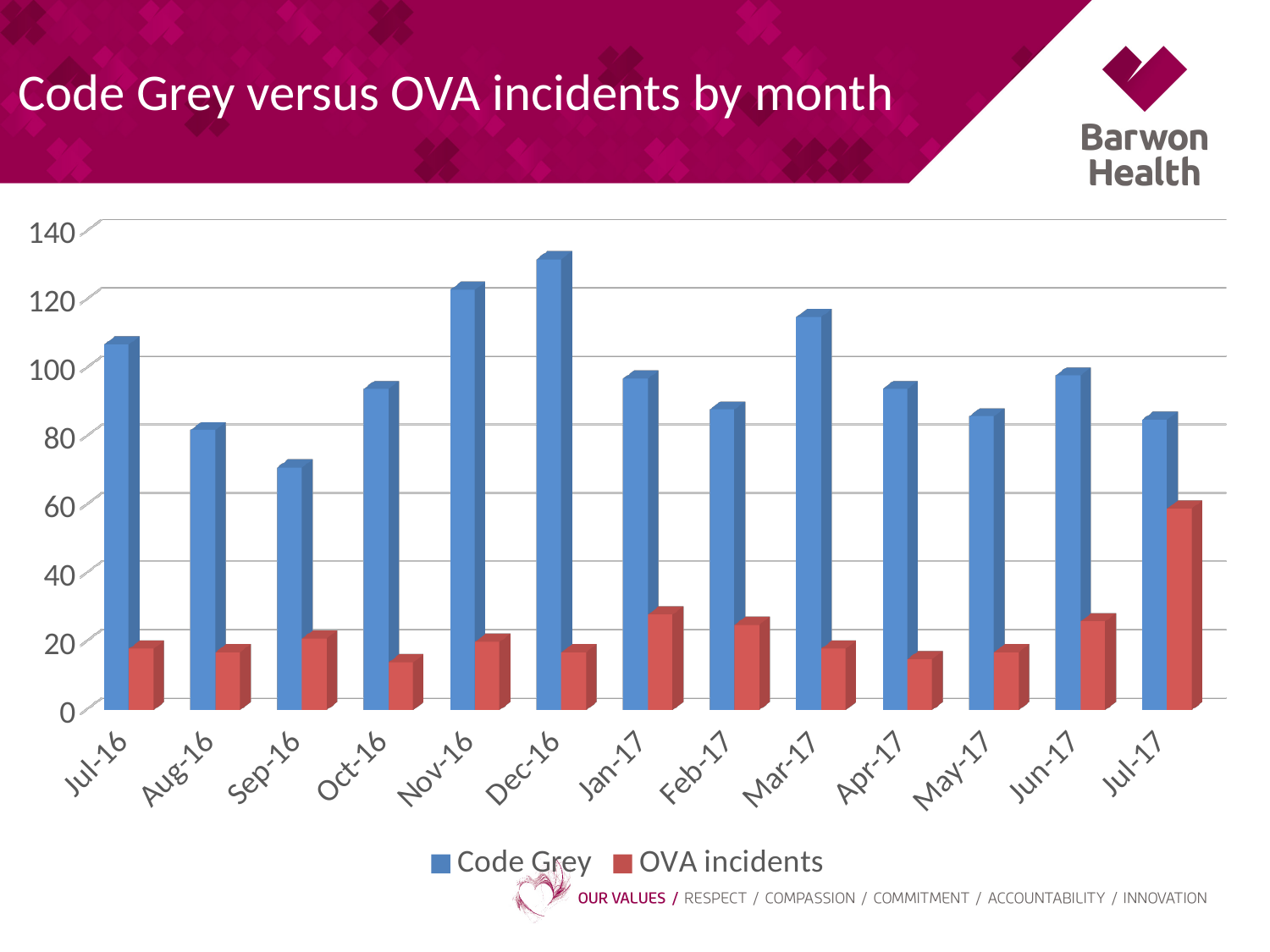
Is the OVA incidents value for Jul-17 greater or less than 40? greater How many months are shown on the x axis? 13 Which month has the larger Code Grey value, Nov-16 or Mar-17? Nov-16 In which month is the Code Grey value highest? Dec-16 Is the Code Grey value for Sep-16 greater or less than 80? less What is the title of the chart? Code Grey versus OVA incidents by month Is the Code Grey value for Dec-16 greater or less than 120? greater Do the Code Grey values rise or fall from Sep-16 to Dec-16? rise What kind of chart is shown on the slide? bar chart In which month is the Code Grey value lowest? Sep-16 How many series does the legend list? 2 In which month is the OVA incidents value highest? Jul-17